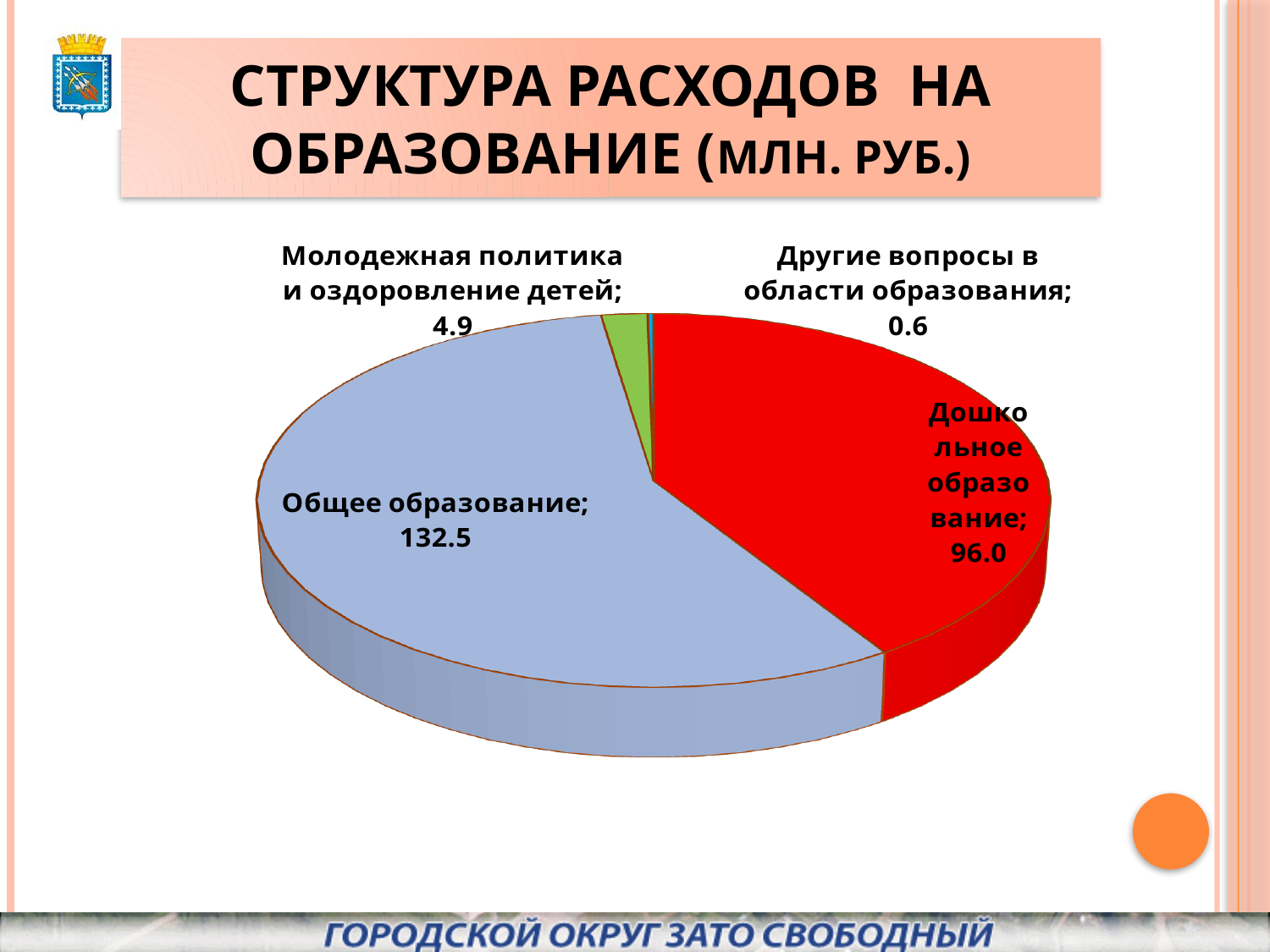
What is the total of all slices in the pie chart? 234.0 Which category has the smallest slice of the pie? Другие вопросы в области образования How many categories are shown in the pie chart? 4 Which category has the largest slice of the pie? Общее образование What kind of chart is shown on the slide? Pie chart What unit is given in the chart title? млн. руб. What is the difference between the values for Общее образование and Дошкольное образование? 36.5 Which is larger, Молодежная политика и оздоровление детей or Другие вопросы в области образования? Молодежная политика и оздоровление детей What is the value for Молодежная политика и оздоровление детей? 4.9 What is the value for Общее образование? 132.5 What is the value for Другие вопросы в области образования? 0.6 What is the value for Дошкольное образование? 96.0